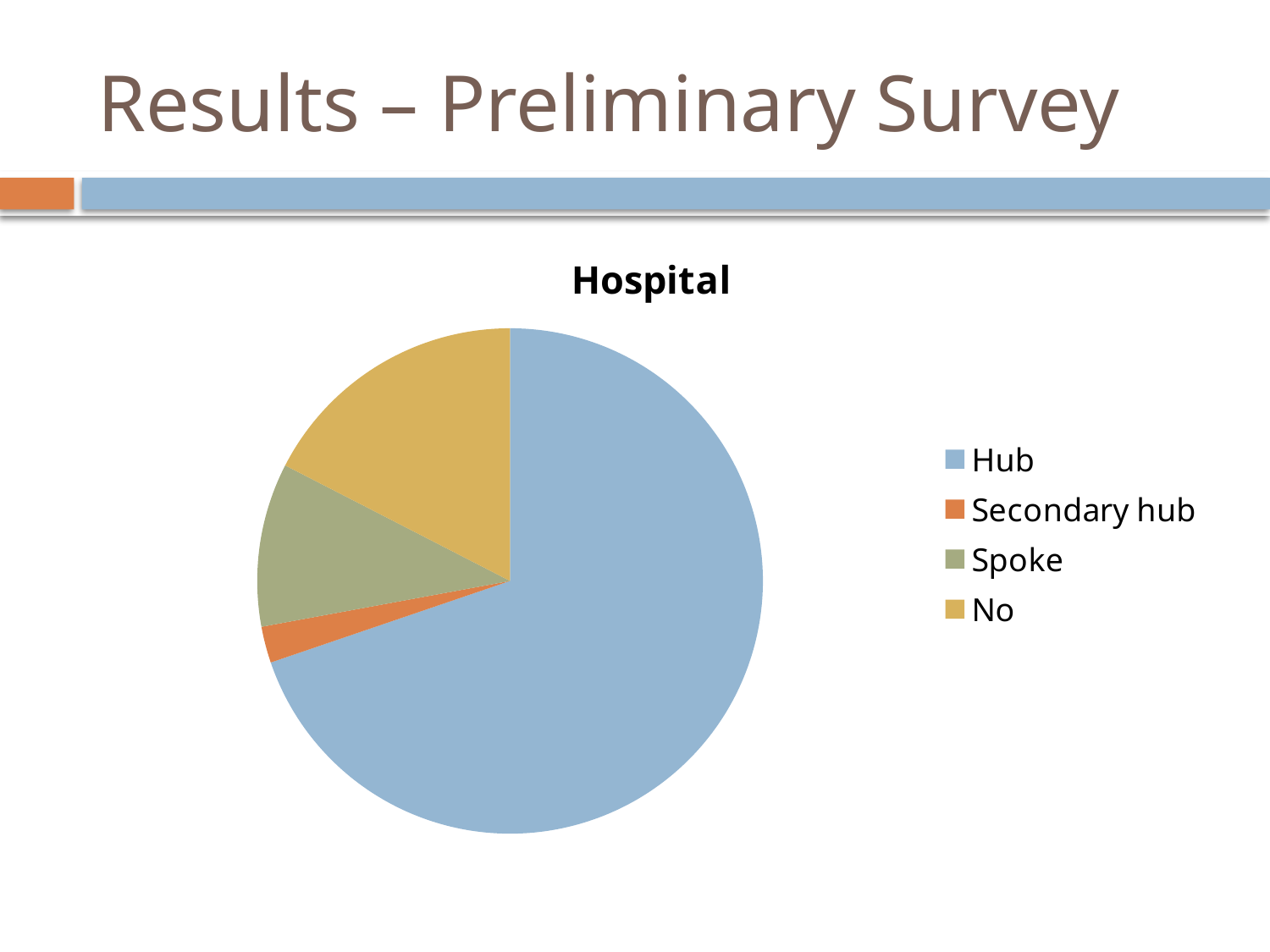
Which category has the largest slice of the pie? Hub Which category has the smallest slice of the pie? Secondary hub What is the title of the chart? Hospital Which category is shown in orange in the pie chart? Secondary hub How many entries does the legend list? 4 Does the Hub slice take up more or less than half of the pie? more What kind of chart is shown on the slide? pie chart Which slice is larger, Hub or No? Hub How many categories does the pie chart show? 4 Which slice is larger, Spoke or Secondary hub? Spoke Which slice is larger, No or Spoke? No